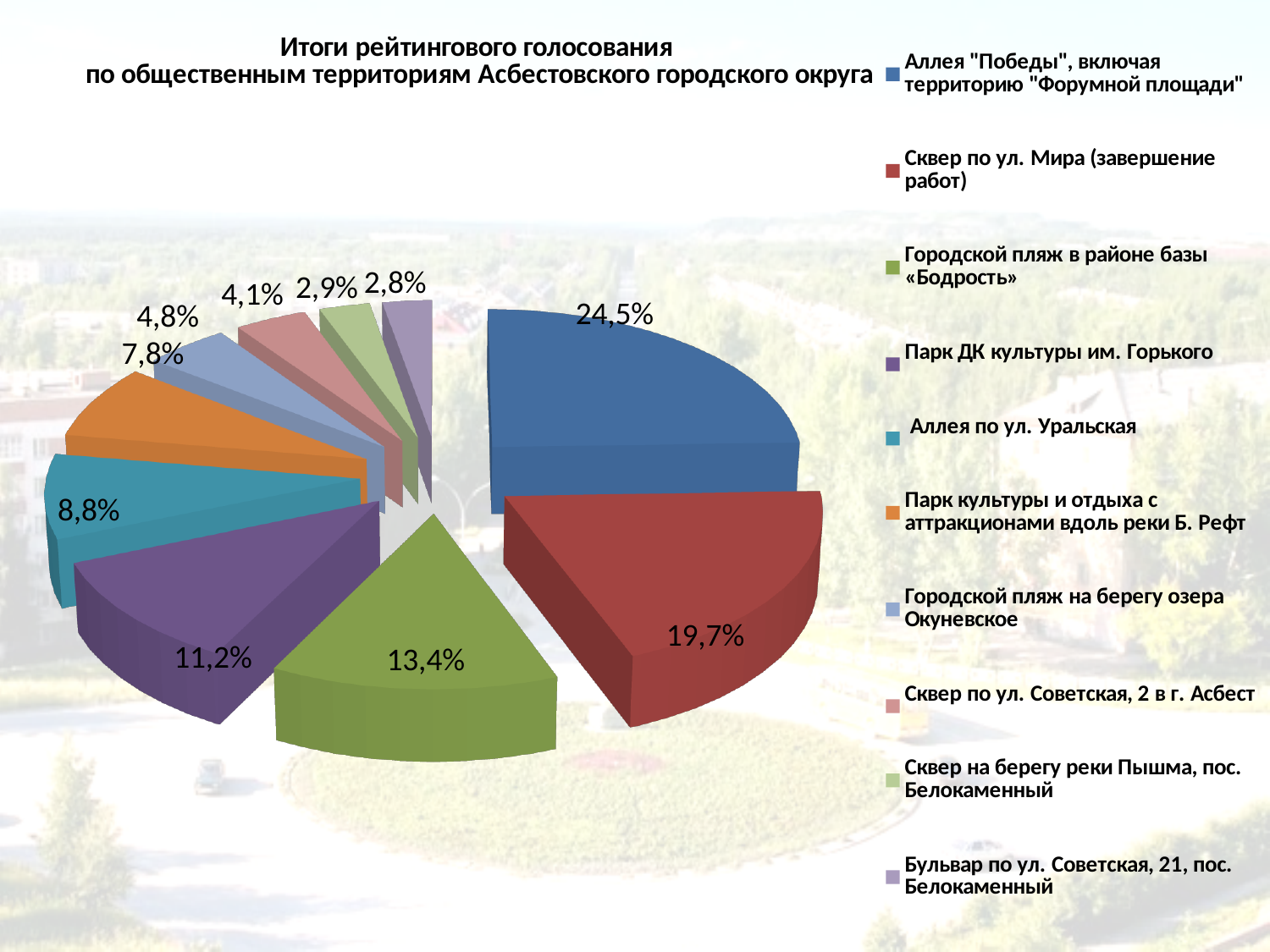
What type of chart is shown on the slide? Pie chart Which territory received the smallest share of the vote? Бульвар по ул. Советская, 21, пос. Белокаменный What percentage did Парк ДК культуры им. Горького receive? 11,2% Which territory received the largest share of the vote? Аллея "Победы", включая территорию "Форумной площади" What is the difference in percentage points between Аллея "Победы" (24,5%) and Сквер по ул. Мира (19,7%)? 4,8 What is the title of the chart? Итоги рейтингового голосования по общественным территориям Асбестовского городского округа How many slices does the pie chart have? 10 What colour is the slice for Городской пляж в районе базы «Бодрость»? Green What value is labelled for Городской пляж в районе базы «Бодрость»? 13,4% What percentage is shown for Сквер по ул. Мира (завершение работ)? 19,7% Which received a larger share: Аллея по ул. Уральская or Парк культуры и отдыха с аттракционами вдоль реки Б. Рефт? Аллея по ул. Уральская What share of the vote did Аллея "Победы", включая территорию "Форумной площади" receive? 24,5%